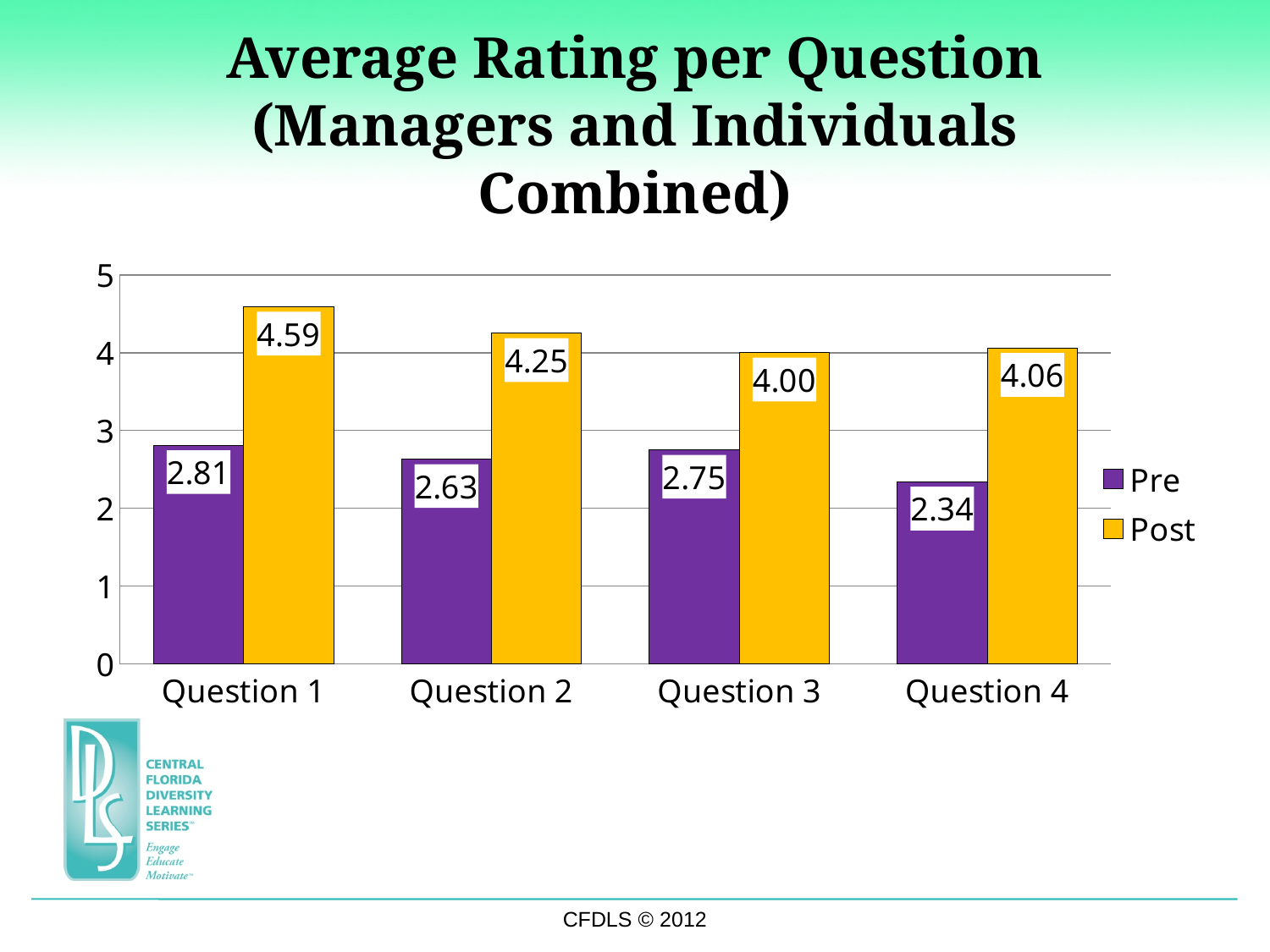
Is the Post rating for Question 2 greater or less than 4? greater Which is larger, the Pre rating for Question 1 or the Pre rating for Question 3? Pre rating for Question 1 What is the Pre rating for Question 1? 2.81 What is the Post rating for Question 4? 4.06 Which question has the lowest Pre rating? Question 4 What is the difference between the Post and Pre ratings for Question 2? 1.62 How many questions are shown on the x axis? 4 What is the Post rating for Question 3? 4.00 How many series does the legend list? 2 What kind of chart is shown on the slide? Bar chart Which colour represents the Post series in the chart? Yellow Which question has the highest Post rating? Question 1